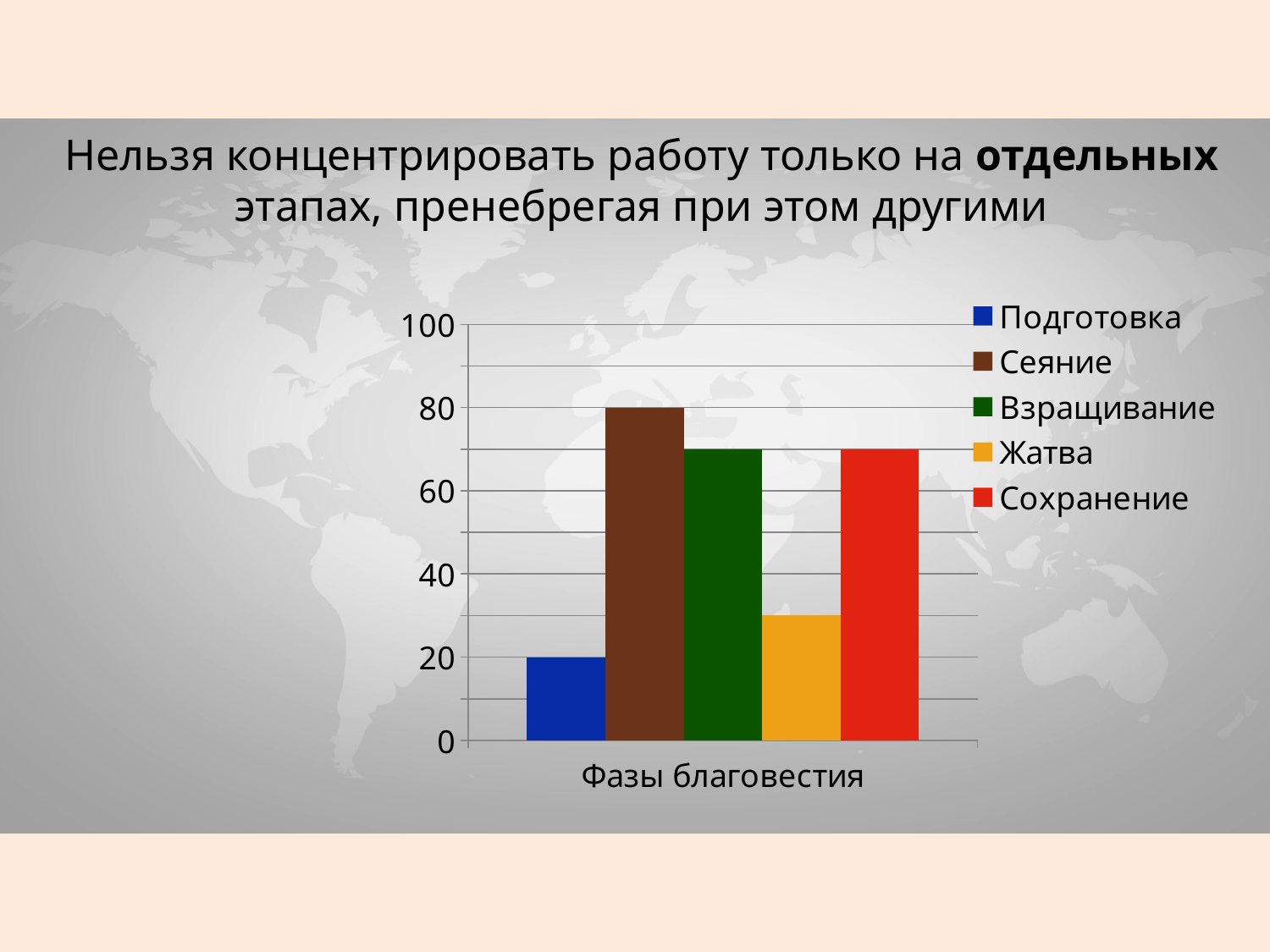
Which series has the highest bar? Сеяние Is the value for Жатва greater or less than 40? less What kind of chart is shown on the slide? bar chart What is the value of the Подготовка bar? 20 What is the difference between the Сеяние bar and the Подготовка bar? 60 Is the value for Сохранение greater or less than 80? less How many series does the legend list? 5 Is the value for Взращивание greater or less than 60? greater What is the value of the Сеяние bar? 80 Which is larger, the Сеяние bar or the Жатва bar? Сеяние Which series has the lowest bar? Подготовка What is the category label shown on the x axis? Фазы благовестия